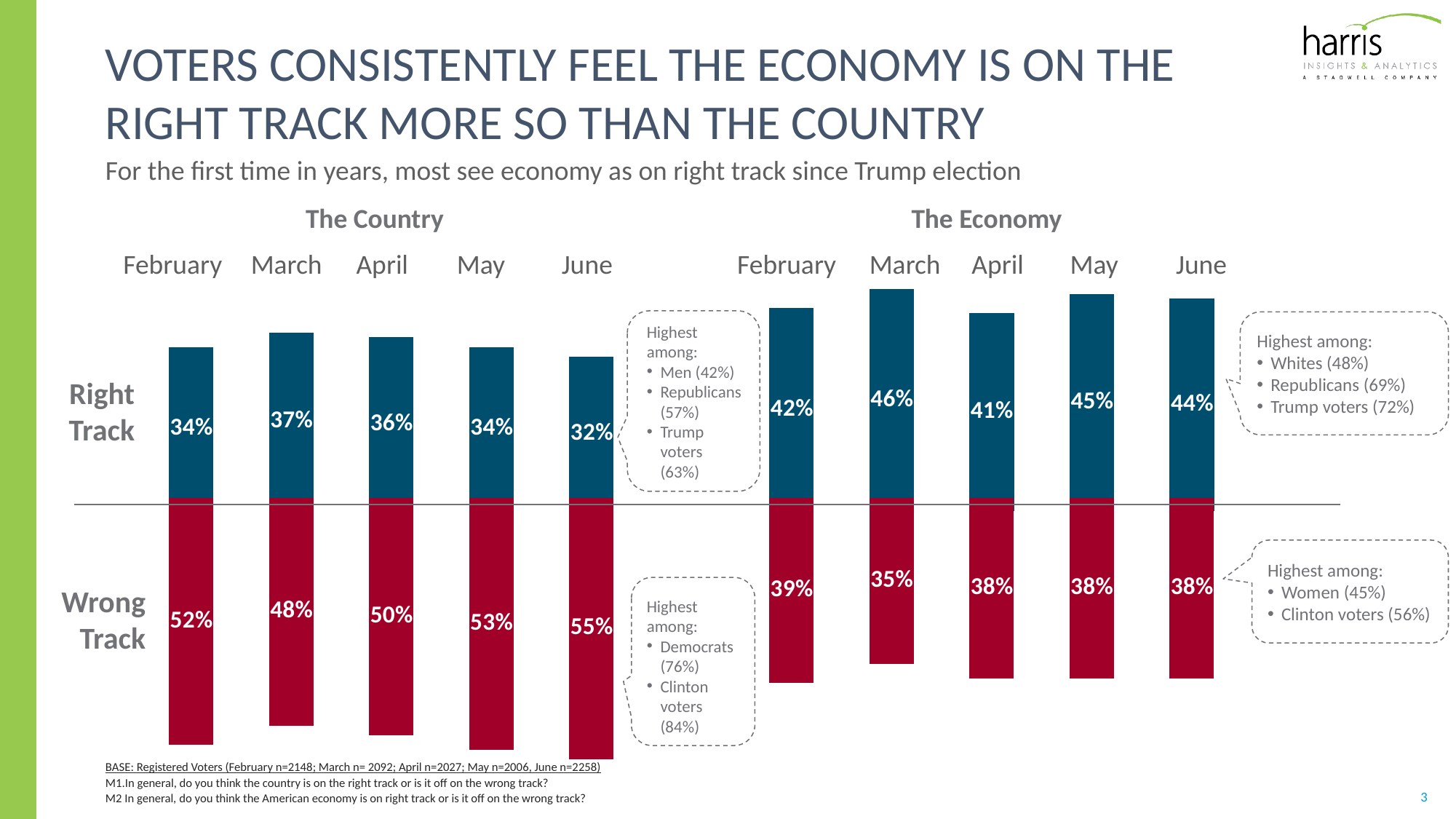
How many months are shown in The Country chart? 5 In The Country chart, what is the difference between the Wrong Track and Right Track percentages in June? 23 percentage points In The Economy chart, which month has the lowest Right Track percentage? April What colour are the Wrong Track bars in both charts? Red In The Economy chart, what is the difference between the Right Track percentages in March and April? 5 percentage points In The Economy chart, what percentage of voters said Wrong Track in February? 39% Which is larger: the Right Track percentage for The Country in February or for The Economy in February? The Economy in February (42%) In The Country chart, which month has the highest Wrong Track percentage? June In The Country chart, what percentage of voters said Right Track in March? 37% What type of chart is used to show The Economy data? Bar chart In The Economy chart, which month has the highest Right Track percentage? March In The Country chart, does the Right Track percentage rise or fall from April to June? Fall